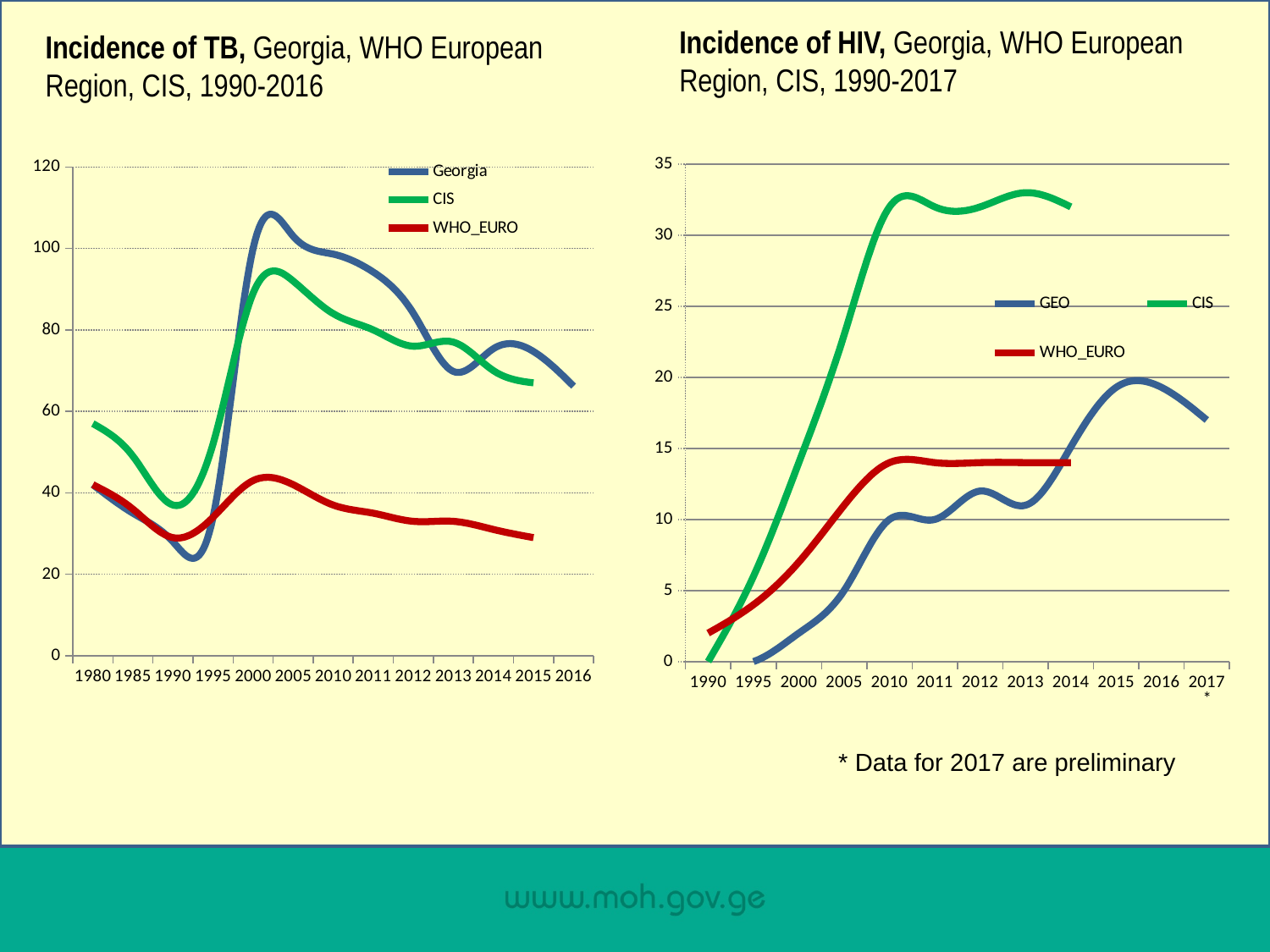
In the 'Incidence of TB' chart, which series has the highest value in 2000? Georgia How many years are labelled on the x axis of the 'Incidence of HIV' chart? 12 How many years are labelled on the x axis of the 'Incidence of TB' chart? 13 How many series does the legend of the 'Incidence of HIV' chart list? 3 In the 'Incidence of HIV' chart, is the value for CIS in 2010 greater or less than 30? greater In the 'Incidence of TB' chart, is the value for WHO_EURO in 2015 greater or less than 40? less In the 'Incidence of HIV' chart, which is larger in 2014, CIS or GEO? CIS In the 'Incidence of HIV' chart, is the value for GEO in 2017 greater or less than 20? less In the 'Incidence of HIV' chart, which series has the lowest value in 2005? GEO In the 'Incidence of HIV' chart, does the CIS line rise or fall from 1990 to 2010? rise What kind of chart is the 'Incidence of TB' chart on the left? line chart